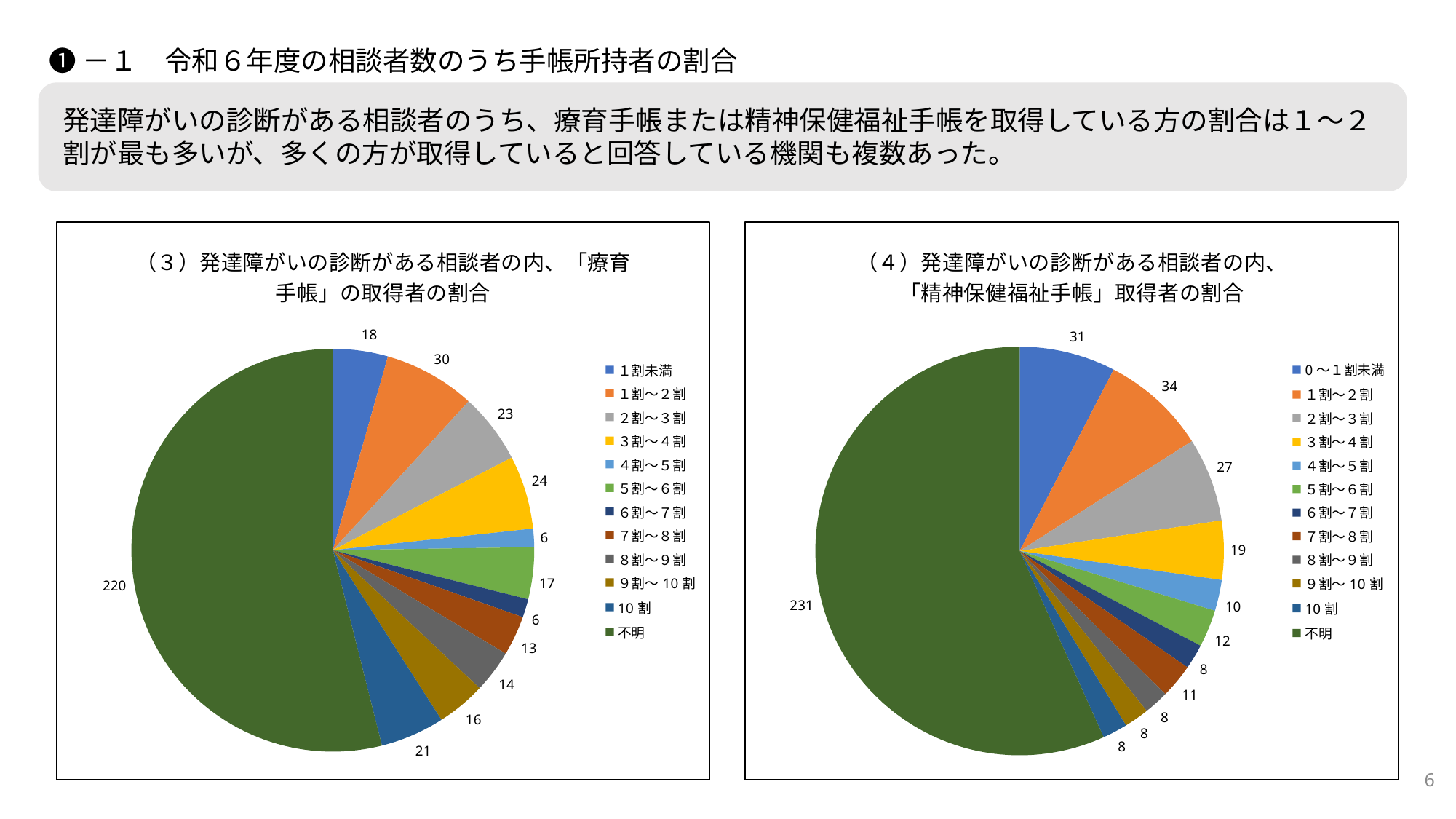
In the left pie chart (療育手帳), what is the difference between the 3割〜4割 slice and the 2割〜3割 slice? 1 In the right pie chart (精神保健福祉手帳), what is the difference between the 0〜1割未満 slice and the 1割〜2割 slice? 3 In the left pie chart (療育手帳), excluding 不明, which category has the largest value? 1割〜2割 What type of chart is used on the left side of the slide? Pie chart In the right pie chart (精神保健福祉手帳), what is the value for the 1割〜2割 slice? 34 In the left pie chart (療育手帳), what is the value for the 不明 slice? 220 In the right pie chart (精神保健福祉手帳), which category has the largest slice? 不明 In the left pie chart (療育手帳), what colour is the 不明 slice? Dark green How many categories does the legend of the right pie chart (精神保健福祉手帳) list? 12 In the left pie chart (療育手帳), what is the value for the 10割 slice? 21 In the left pie chart (療育手帳), which is larger: the 5割〜6割 slice or the 7割〜8割 slice? 5割〜6割 In the right pie chart (精神保健福祉手帳), what is the value for the 3割〜4割 slice? 19